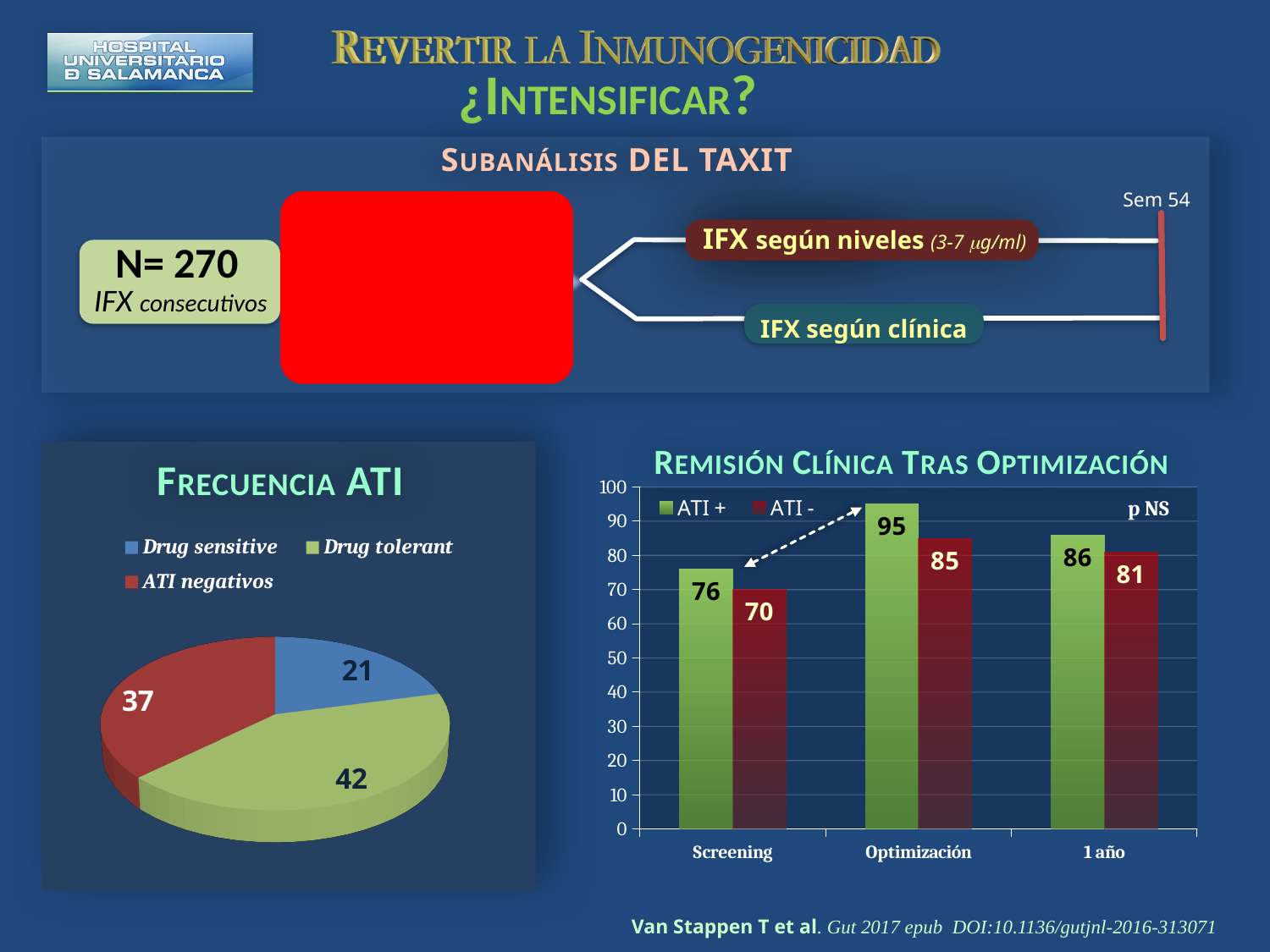
In the 'Frecuencia ATI' chart, which category has the smallest slice? Drug sensitive In the 'Remisión Clínica Tras Optimización' chart, what is the difference between ATI + and ATI - at 1 año? 5 How many series does the legend of the 'Remisión Clínica Tras Optimización' chart list? 2 In the 'Remisión Clínica Tras Optimización' chart, what is the value for ATI - at Screening? 70 In the 'Frecuencia ATI' chart, what share of the pie does the ATI negativos slice represent? 37% In the 'Remisión Clínica Tras Optimización' chart, which category has the highest ATI + value? Optimización What kind of chart is 'Remisión Clínica Tras Optimización'? Bar chart In the 'Remisión Clínica Tras Optimización' chart, which is larger at Screening: ATI + or ATI -? ATI + In the 'Frecuencia ATI' chart, what is the value for Drug tolerant? 42 What kind of chart is 'Frecuencia ATI'? Pie chart In the 'Remisión Clínica Tras Optimización' chart, what is the value for ATI + at Optimización? 95 How many categories does the legend of the 'Frecuencia ATI' chart list? 3